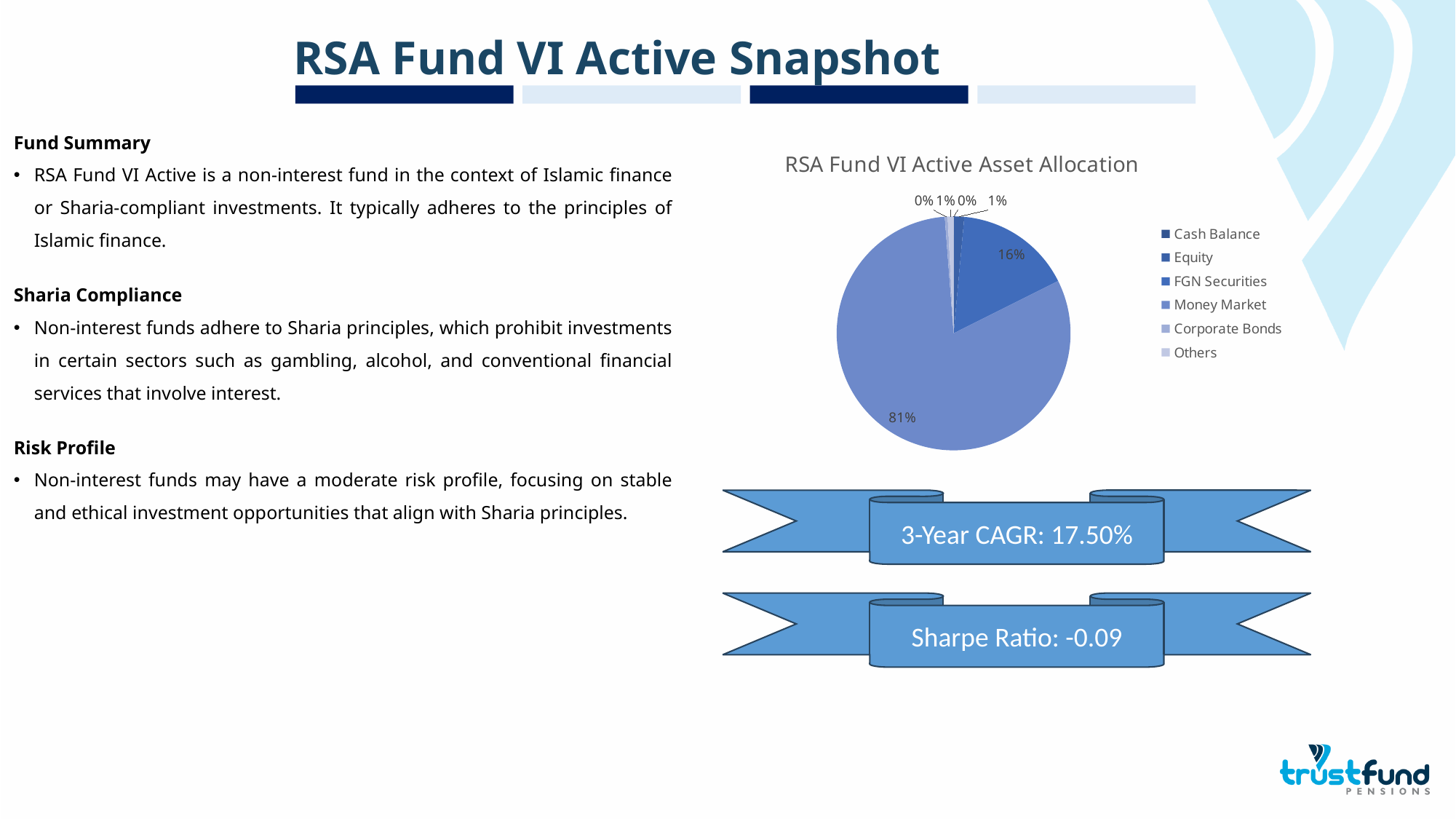
What is the title of the chart on the slide? RSA Fund VI Active Asset Allocation What share of the asset allocation is Money Market? 81% By how many percentage points does the Money Market share exceed the FGN Securities share? 65 percentage points Which is larger in the asset allocation pie chart, Money Market or FGN Securities? Money Market What share of the asset allocation is FGN Securities? 16% How many categories does the legend of the asset allocation pie chart list? 6 Which asset class has the largest share in the RSA Fund VI Active Asset Allocation pie chart? Money Market What kind of chart is shown on the slide? Pie chart What is the combined share of Money Market and FGN Securities in the pie chart? 97% Which legend entry is listed first in the asset allocation pie chart? Cash Balance What is the second-largest slice in the asset allocation pie chart? FGN Securities